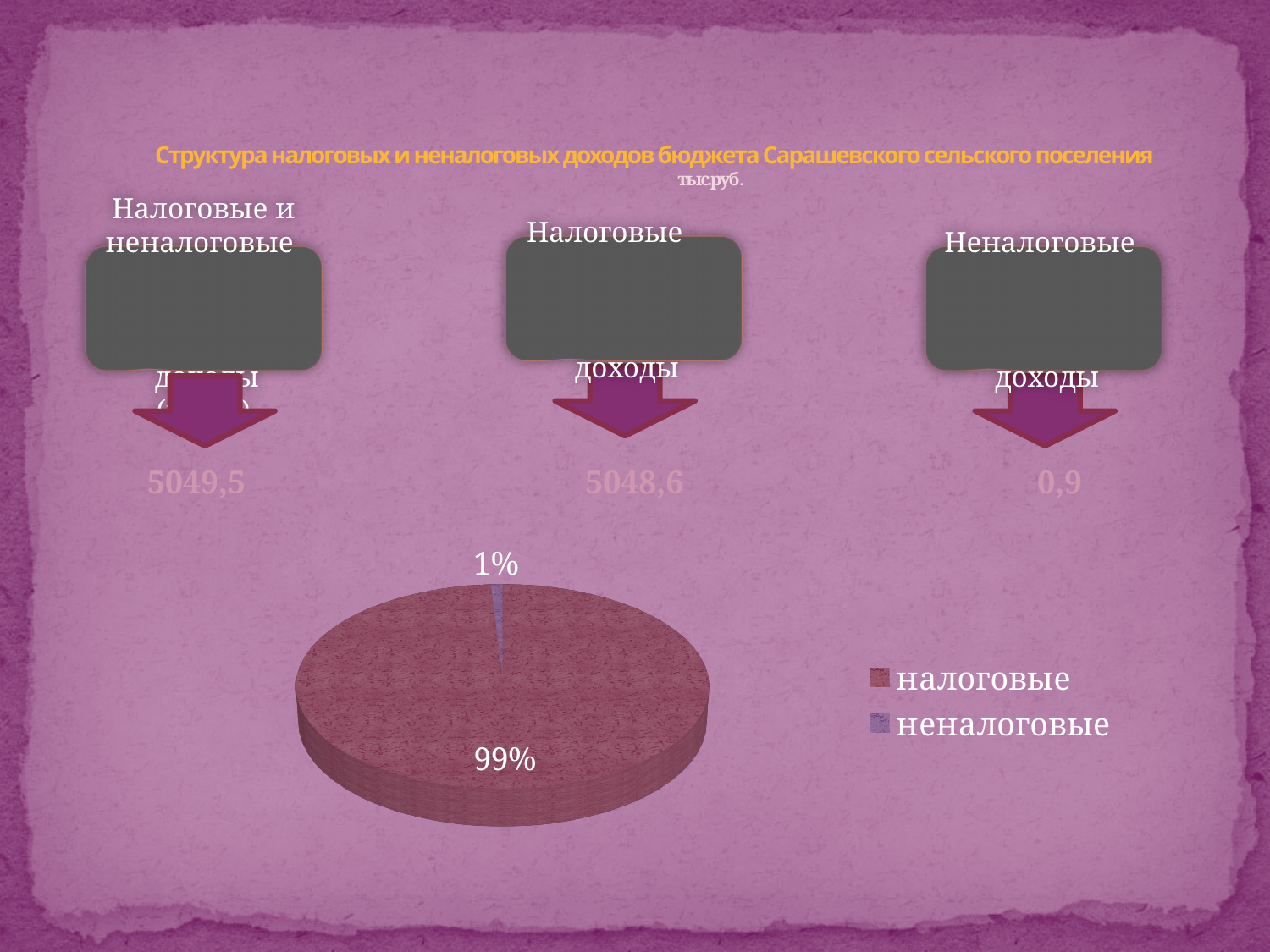
How many entries does the legend of the pie chart list? 2 Which slice of the pie chart is the smallest? неналоговые What is the total of the two percentages shown on the pie chart? 100% What share of the pie does the "налоговые" slice represent? 99% What share of the pie does the "неналоговые" slice represent? 1% What are the two legend entries of the pie chart? налоговые, неналоговые What is the difference in percentage points between the "налоговые" and "неналоговые" slices? 98 What kind of chart is shown on the slide? pie chart Is the share of the "налоговые" slice greater or less than 50%? greater How many slices does the pie chart have? 2 Which slice of the pie chart is the largest? налоговые Which is larger in the pie chart, "налоговые" or "неналоговые"? налоговые